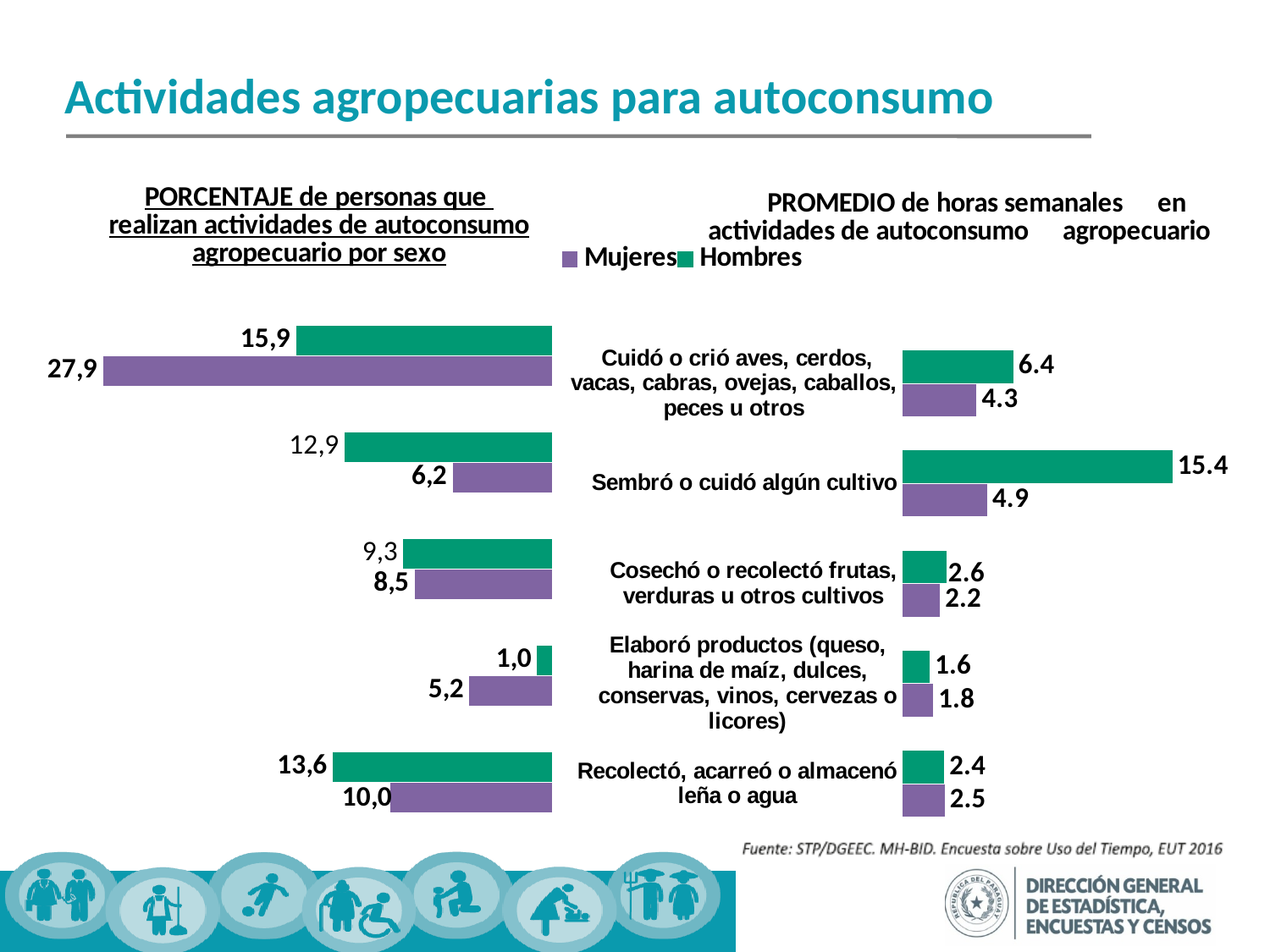
In the PROMEDIO de horas semanales chart on the right, what is the difference between the Hombres and Mujeres values for 'Sembró o cuidó algún cultivo'? 10.5 In the PORCENTAJE chart on the left, which category has the lowest value for Hombres? Elaboró productos (queso, harina de maíz, dulces, conservas, vinos, cervezas o licores) In the PROMEDIO de horas semanales chart on the right, which category has the highest value for Hombres? Sembró o cuidó algún cultivo How many series does the legend list? 2 In the PORCENTAJE chart on the left, what is the difference between the Mujeres and Hombres values for 'Cuidó o crió aves, cerdos, vacas, cabras, ovejas, caballos, peces u otros'? 12,0 In the PORCENTAJE chart on the left, which is larger for 'Recolectó, acarreó o almacenó leña o agua': Mujeres or Hombres? Hombres How many categories are shown in the PROMEDIO de horas semanales chart on the right? 5 In the PORCENTAJE chart on the left, what is the value for Hombres for 'Sembró o cuidó algún cultivo'? 12,9 In the PROMEDIO de horas semanales chart on the right, what is the value for Hombres for 'Sembró o cuidó algún cultivo'? 15.4 In the PORCENTAJE chart on the left, what is the value for Mujeres for 'Cuidó o crió aves, cerdos, vacas, cabras, ovejas, caballos, peces u otros'? 27,9 In the PORCENTAJE chart on the left, which category has the highest value for Mujeres? Cuidó o crió aves, cerdos, vacas, cabras, ovejas, caballos, peces u otros In the PROMEDIO de horas semanales chart on the right, what is the value for Mujeres for 'Recolectó, acarreó o almacenó leña o agua'? 2.5